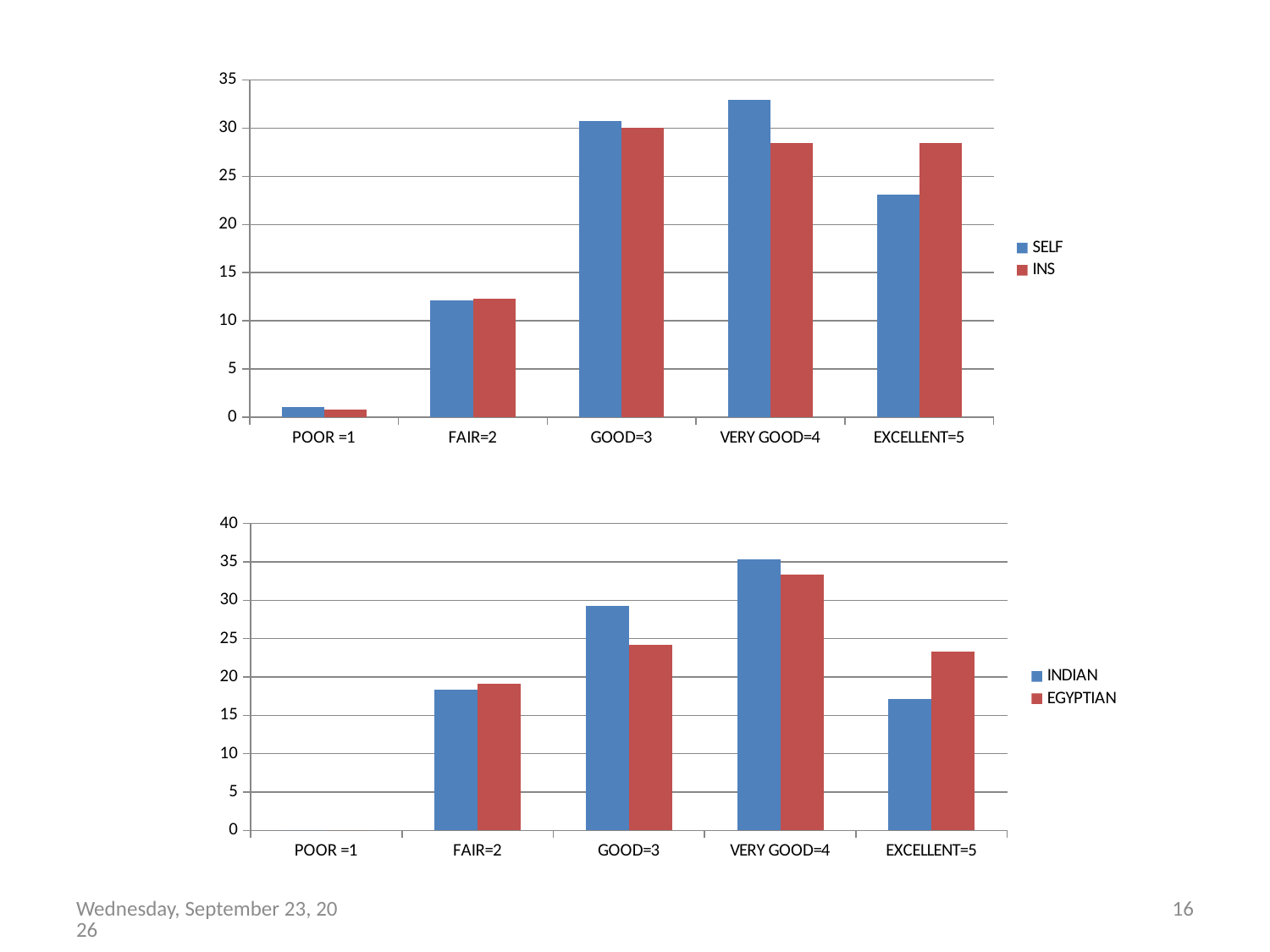
How many series does the legend of the top chart list? 2 How many categories are shown on the x axis of the bottom chart? 5 What are the two legend entries of the bottom chart? INDIAN and EGYPTIAN What kind of chart is the top chart on the slide? bar chart In the top chart, for EXCELLENT=5, which series has the larger value, SELF or INS? INS In the bottom chart, for GOOD=3, which series has the larger value, INDIAN or EGYPTIAN? INDIAN In the top chart, is the INS value for EXCELLENT=5 greater or less than 25? greater In the bottom chart, is the EGYPTIAN value for EXCELLENT=5 greater or less than 20? greater In the top chart, is the SELF value for VERY GOOD=4 greater or less than 30? greater In the top chart, which category has the highest SELF value? VERY GOOD=4 In the bottom chart, which category has the highest INDIAN value? VERY GOOD=4 In the top chart, which category has the lowest INS value? POOR =1